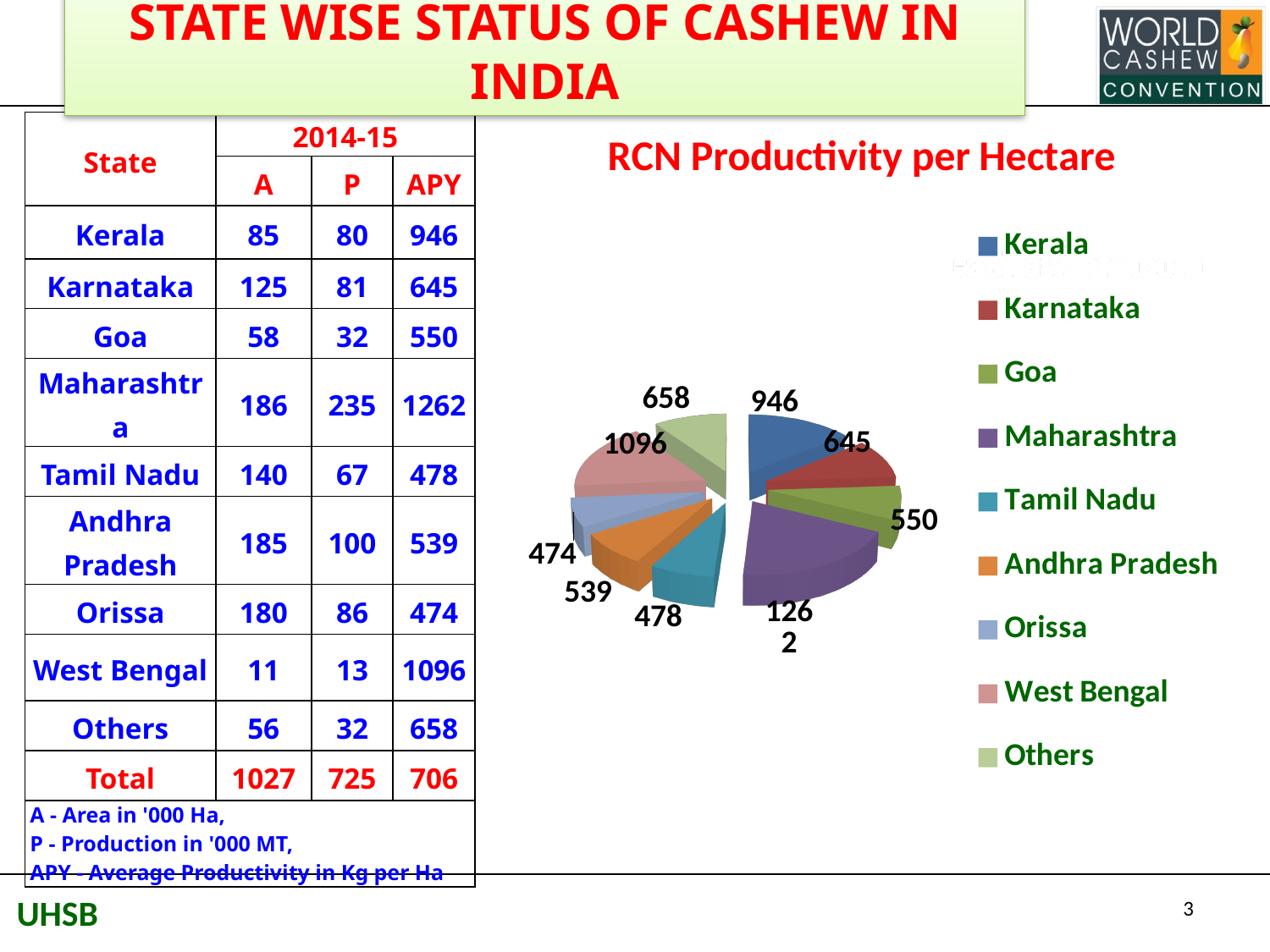
Which state has the largest slice in the RCN Productivity per Hectare pie chart? Maharashtra How many slices does the RCN Productivity per Hectare pie chart have? 9 In the RCN Productivity per Hectare pie chart, what is the value for West Bengal? 1096 What type of chart is shown under the title 'RCN Productivity per Hectare'? pie chart In the RCN Productivity per Hectare pie chart, what is the difference between the values for West Bengal and Others? 438 What colour is the Maharashtra slice in the RCN Productivity per Hectare pie chart? purple In the RCN Productivity per Hectare pie chart, what is the value for Goa? 550 In the RCN Productivity per Hectare pie chart, which is larger, the value for Kerala or the value for Karnataka? Kerala In the RCN Productivity per Hectare pie chart, what is the difference between the values for Maharashtra and Kerala? 316 Which state has the smallest slice in the RCN Productivity per Hectare pie chart? Orissa In the RCN Productivity per Hectare pie chart, what is the value for Andhra Pradesh? 539 In the RCN Productivity per Hectare pie chart, what is the value for Kerala? 946